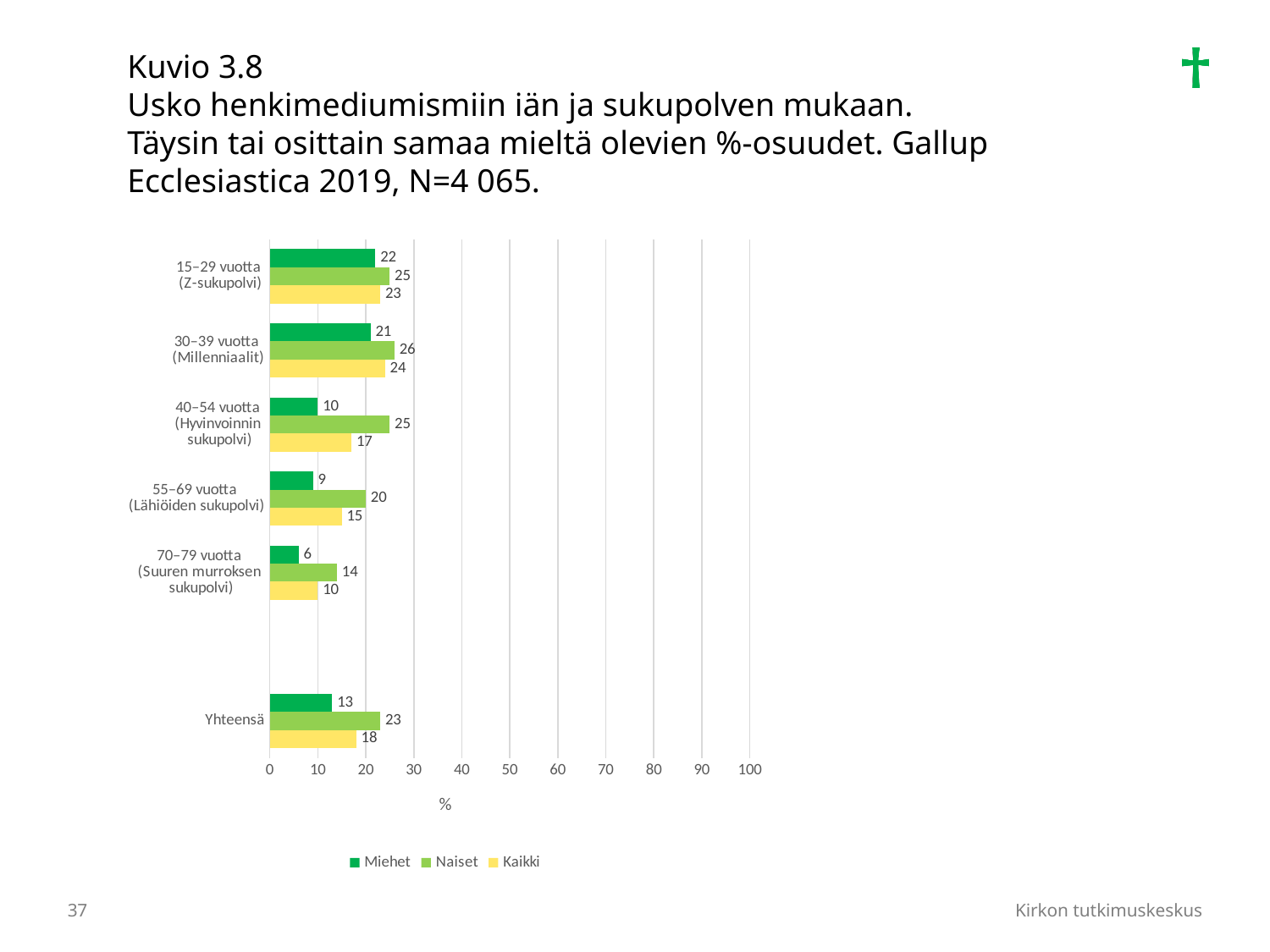
What kind of chart is shown on the slide? bar chart Which is larger in the 55–69 vuotta (Lähiöiden sukupolvi) category, the Miehet value or the Kaikki value? Kaikki What is the difference between the Naiset and Miehet values in the 40–54 vuotta (Hyvinvoinnin sukupolvi) category? 15 What are the three series listed in the legend? Miehet, Naiset, Kaikki Which category has the lowest value for Naiset? 70–79 vuotta (Suuren murroksen sukupolvi) Which category has the highest value for Miehet? 15–29 vuotta (Z-sukupolvi) What is the value for Miehet in the 70–79 vuotta (Suuren murroksen sukupolvi) category? 6 How many age/generation categories are shown on the chart, including Yhteensä? 6 What is the maximum value shown on the horizontal axis? 100 What is the value for Naiset in the 30–39 vuotta (Millenniaalit) category? 26 How many series does the legend list? 3 What is the value for Kaikki in the Yhteensä category? 18